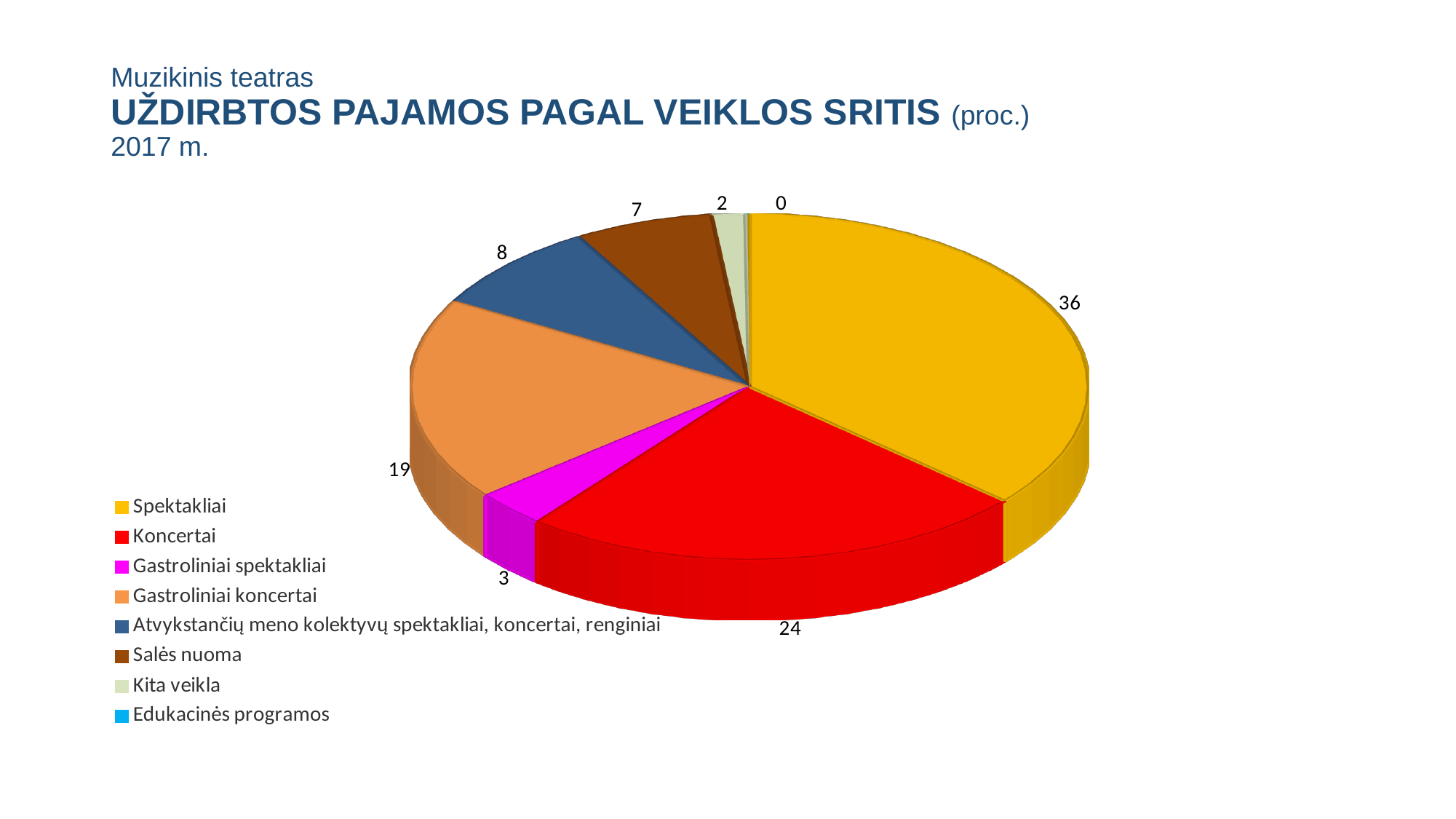
What type of chart is shown on the slide? pie chart What year is shown in the chart title? 2017 m. How many categories does the legend list? 8 What is the value for Edukacinės programos? 0 What is the value for Spektakliai? 36 Which is larger, Gastroliniai koncertai or Atvykstančių meno kolektyvų spektakliai, koncertai, renginiai? Gastroliniai koncertai What is the value for Salės nuoma? 7 What is the value for Koncertai? 24 Which category has the smallest value? Edukacinės programos Which category has the largest share of the pie? Spektakliai What is the difference between the values for Spektakliai and Koncertai? 12 What is the value for Gastroliniai koncertai? 19